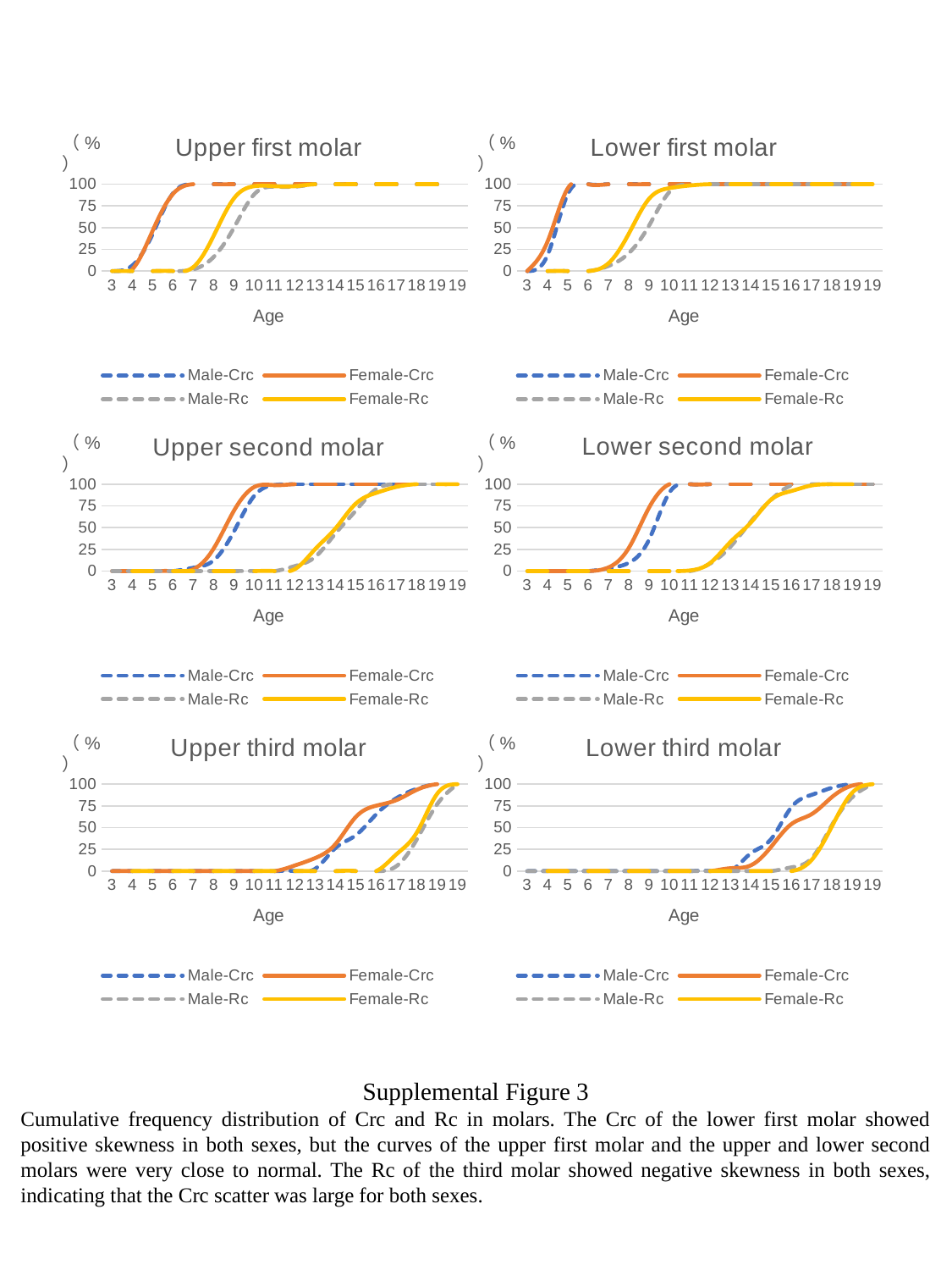
In the "Upper first molar" chart, is the value for Female-Crc at age 7 greater or less than 50? greater In the "Lower second molar" chart, is the value for Female-Rc at age 16 greater or less than 75? greater Which series in the "Lower third molar" chart is drawn as a blue dashed line? Male-Crc In the "Upper first molar" chart, at age 9, which is larger: Female-Rc or Male-Rc? Female-Rc In the "Upper third molar" chart, is the value for Female-Crc at age 15 greater or less than 25? greater What kind of chart is the "Upper first molar" chart? line chart What is the x-axis label on the "Upper second molar" chart? Age How many series does the legend of the "Lower first molar" chart list? 4 In the "Lower third molar" chart, do the Female-Rc values rise or fall as age increases? rise